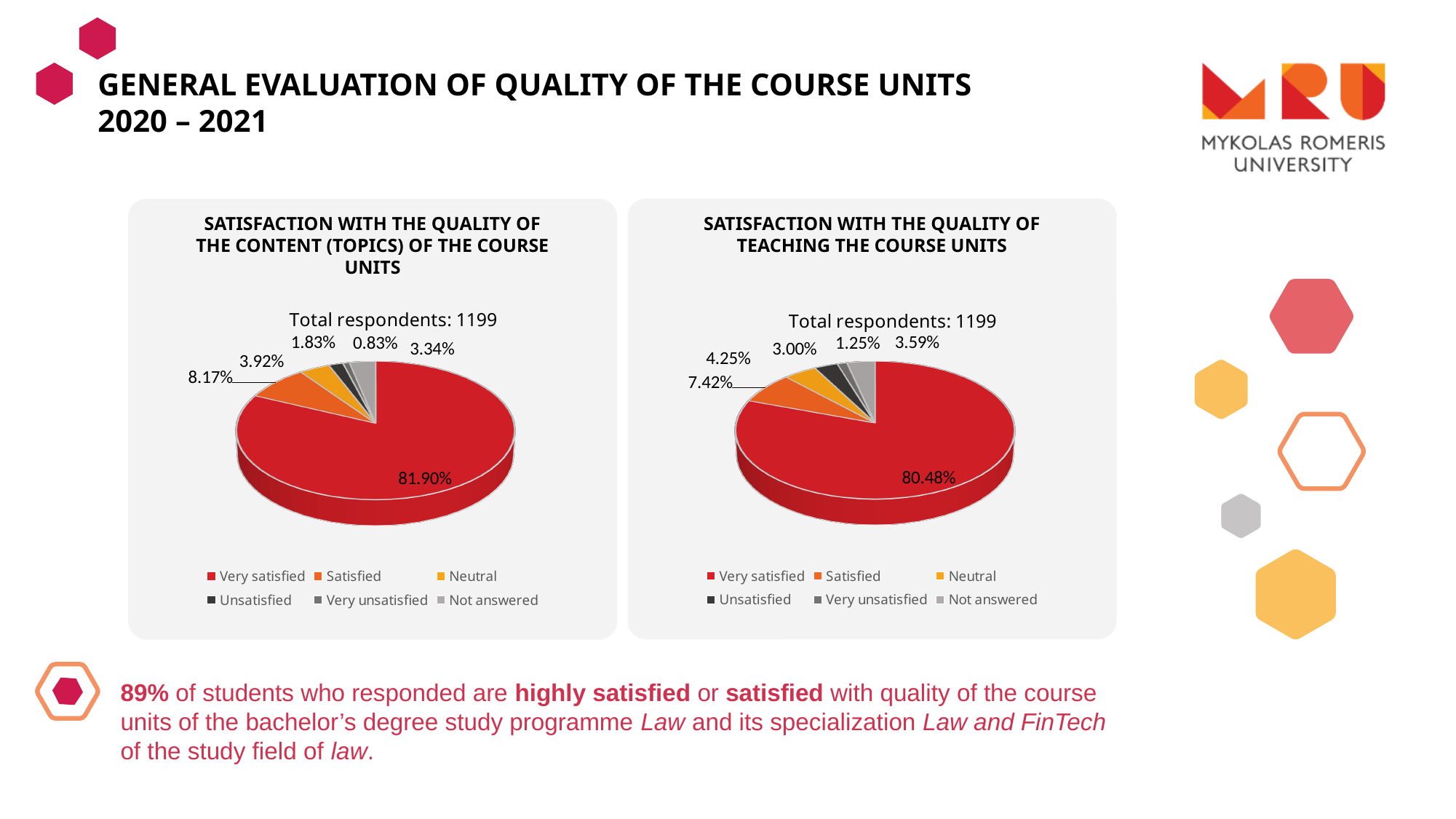
In the chart 'Satisfaction with the quality of teaching the course units', what share of respondents did not answer? 3.59% How many total respondents are reported for the chart 'Satisfaction with the quality of teaching the course units'? 1199 In the chart 'Satisfaction with the quality of teaching the course units', which category has the largest share? Very satisfied In the chart 'Satisfaction with the quality of the content (topics) of the course units', what share of respondents were satisfied? 8.17% Is the 'Neutral' share larger in the content chart or in the teaching chart? Teaching chart What type of chart is used for 'Satisfaction with the quality of the content (topics) of the course units'? Pie chart In the chart 'Satisfaction with the quality of teaching the course units', what share of respondents were satisfied? 7.42% In the chart 'Satisfaction with the quality of the content (topics) of the course units', what share of respondents were very satisfied? 81.90% How many categories does the legend of the chart 'Satisfaction with the quality of teaching the course units' list? 6 What is the difference between the 'Very satisfied' share in the content chart (81.90%) and in the teaching chart (80.48%)? 1.42% In the chart 'Satisfaction with the quality of the content (topics) of the course units', which category has the smallest share? Very unsatisfied In the chart 'Satisfaction with the quality of teaching the course units', what share of respondents were very satisfied? 80.48%